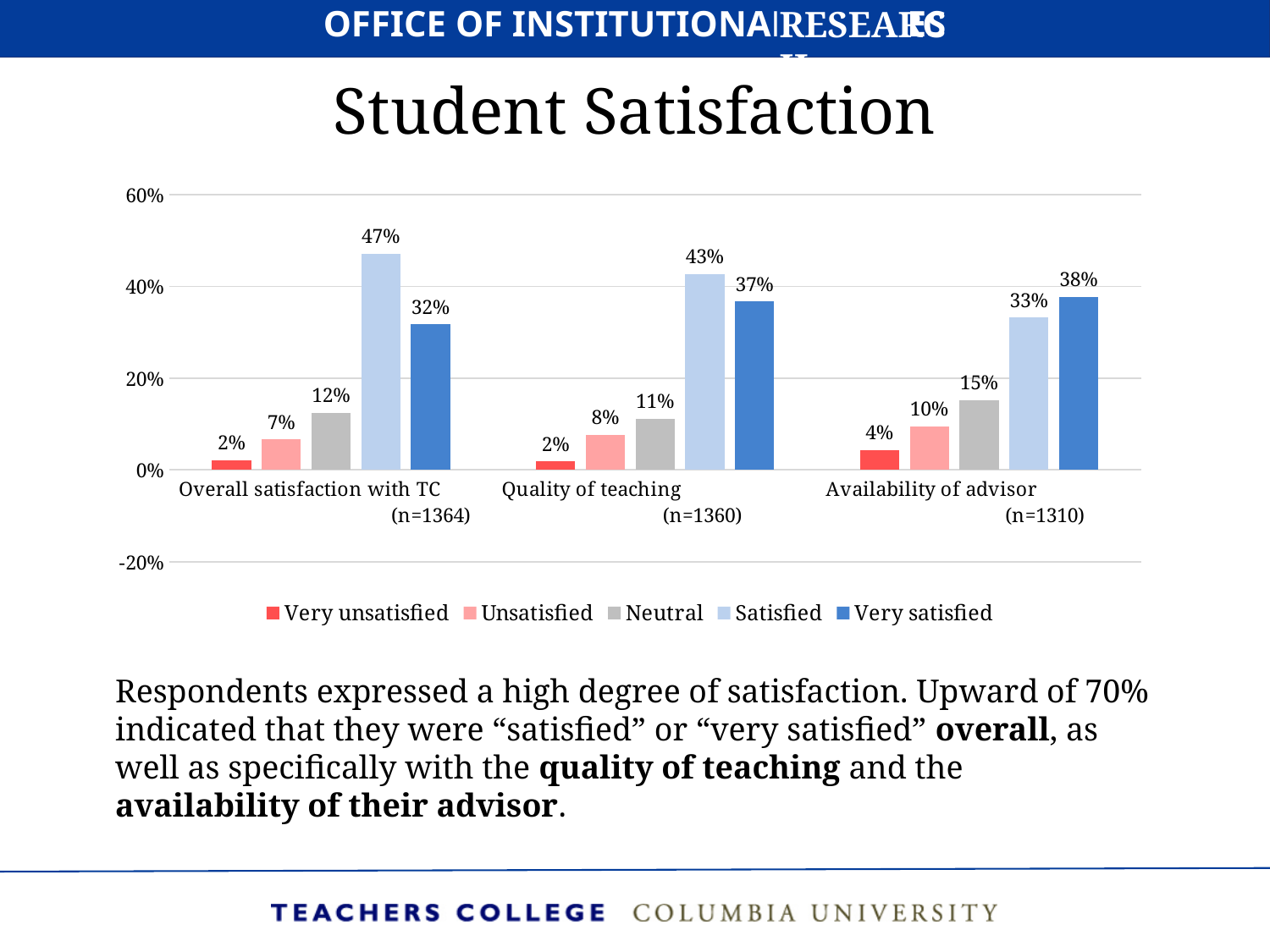
How many categories are shown on the x axis? 3 What percentage of respondents were "Satisfied" with overall satisfaction with TC? 47% For quality of teaching, which is larger: the "Satisfied" or the "Very satisfied" percentage? Satisfied What percentage of respondents were "Neutral" on quality of teaching? 11% What kind of chart is shown on the slide? Bar chart Which category has the lowest "Satisfied" percentage? Availability of advisor Which category has the highest "Very satisfied" percentage? Availability of advisor What is the difference between the "Satisfied" and "Very satisfied" percentages for overall satisfaction with TC? 15% Is the "Satisfied" value for quality of teaching greater or less than 40%? greater What is the sample size (n) shown for the quality of teaching category? n=1360 What percentage of respondents were "Very satisfied" with the availability of advisor? 38% How many series does the legend list? 5